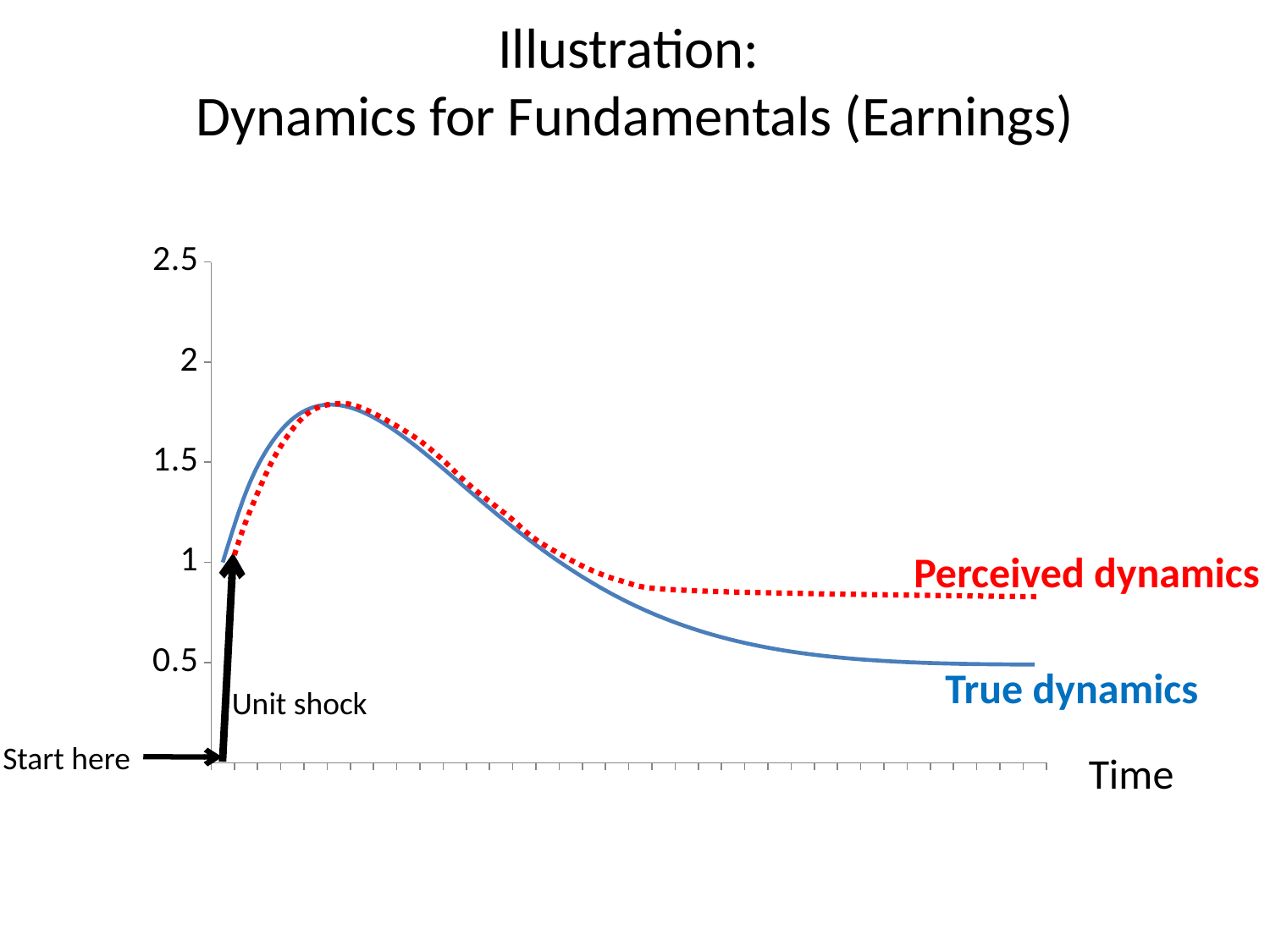
Is the peak value of the Perceived dynamics series greater or less than 2? less At the right end of the chart, is the value of the Perceived dynamics series greater or less than 1? less What kind of chart is shown on the slide? line chart What is the label of the horizontal axis? Time At the right end of the chart, which series has the higher value, True dynamics or Perceived dynamics? Perceived dynamics At the right end of the chart, is the value of the True dynamics series greater or less than 1? less After reaching their peak, do the values of the True dynamics series rise or fall as time increases? fall What is the highest value shown on the vertical axis? 2.5 What is the title of the chart on the slide? Illustration: Dynamics for Fundamentals (Earnings) How many series are plotted on the chart? 2